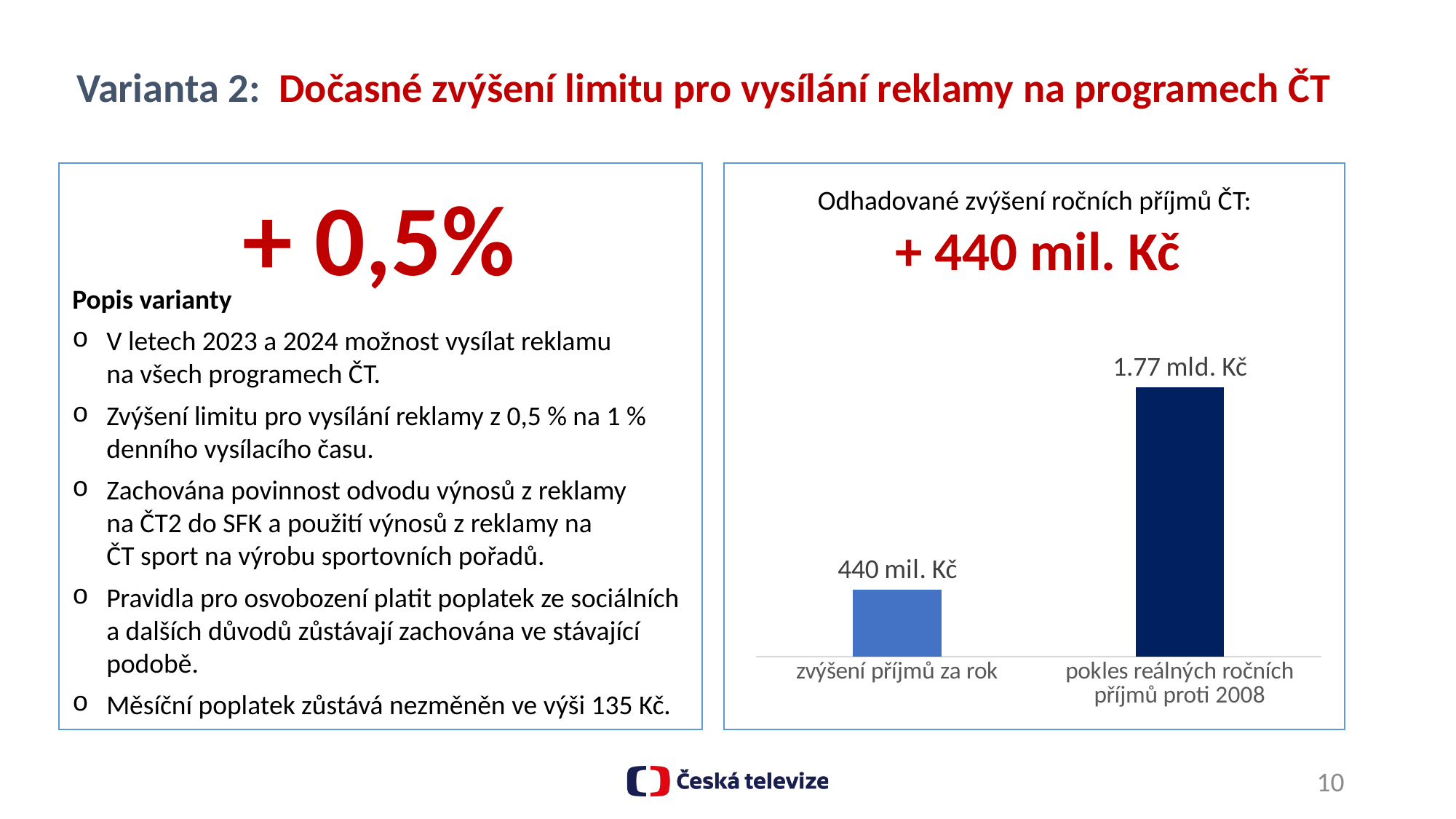
What colour is the bar for "pokles reálných ročních příjmů proti 2008"? dark navy blue What is the value of the bar labelled "zvýšení příjmů za rok"? 440 mil. Kč What is the title text shown above the chart? Odhadované zvýšení ročních příjmů ČT: What type of chart is shown on the slide? bar chart Do the bar values rise or fall from left to right across the chart? rise What is the value of the bar labelled "pokles reálných ročních příjmů proti 2008"? 1.77 mld. Kč Which category has the lowest bar in the chart? zvýšení příjmů za rok Which category has the highest bar in the chart? pokles reálných ročních příjmů proti 2008 How many bars are shown in the chart? 2 Which is larger: the bar for "zvýšení příjmů za rok" or the bar for "pokles reálných ročních příjmů proti 2008"? pokles reálných ročních příjmů proti 2008